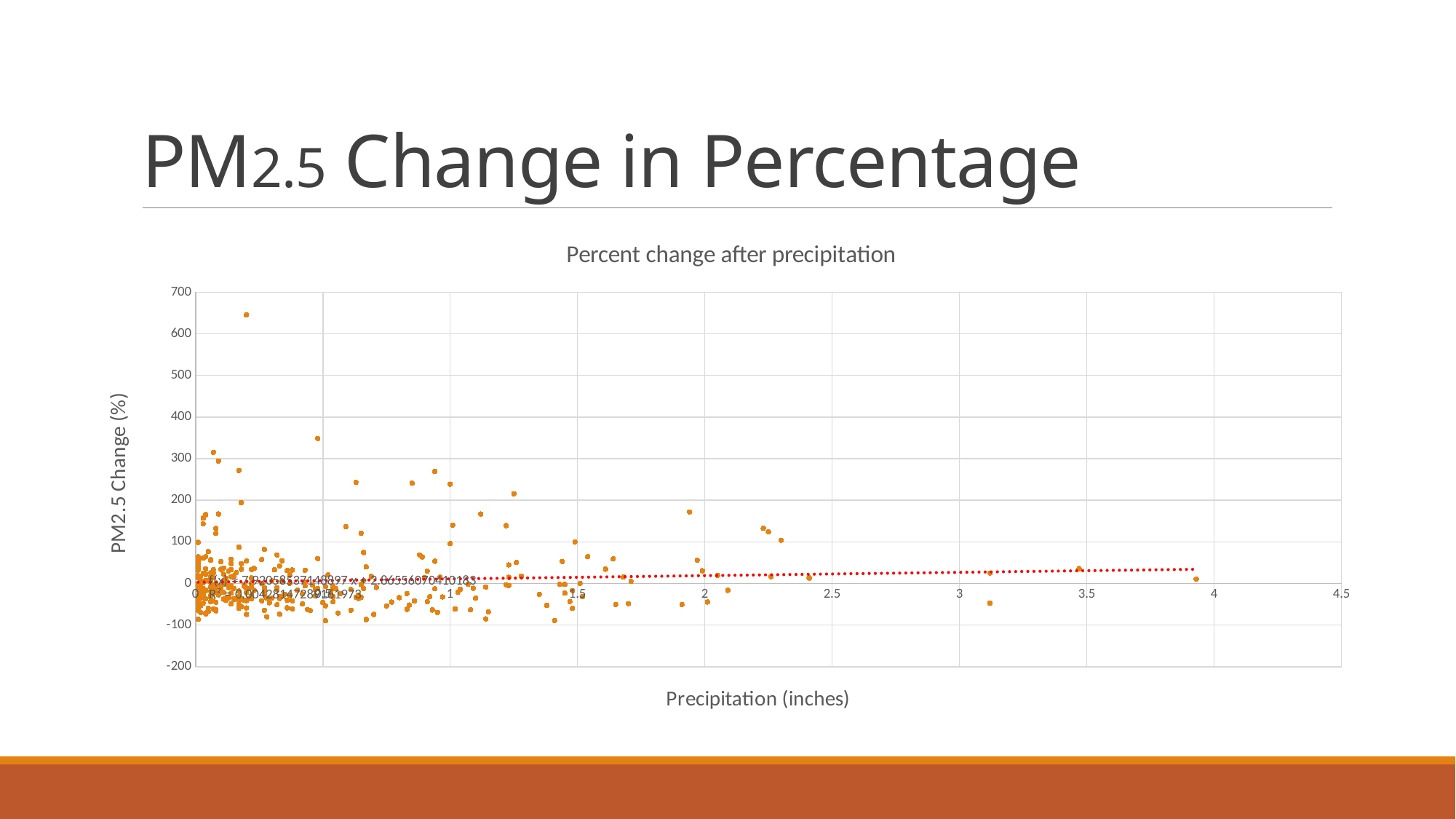
Is the highest plotted PM2.5 change value greater or less than 600? greater Is the highest plotted PM2.5 change value greater or less than 700? less Is the precipitation value of the rightmost plotted point greater or less than 3.5 inches? greater Does the dotted trendline rise or fall as precipitation increases along the x axis? rise What kind of chart is shown on the slide? Scatter plot What is the title of the chart? Percent change after precipitation What is the minimum value shown on the y axis? -200 What is the largest tick value shown on the x axis? 4.5